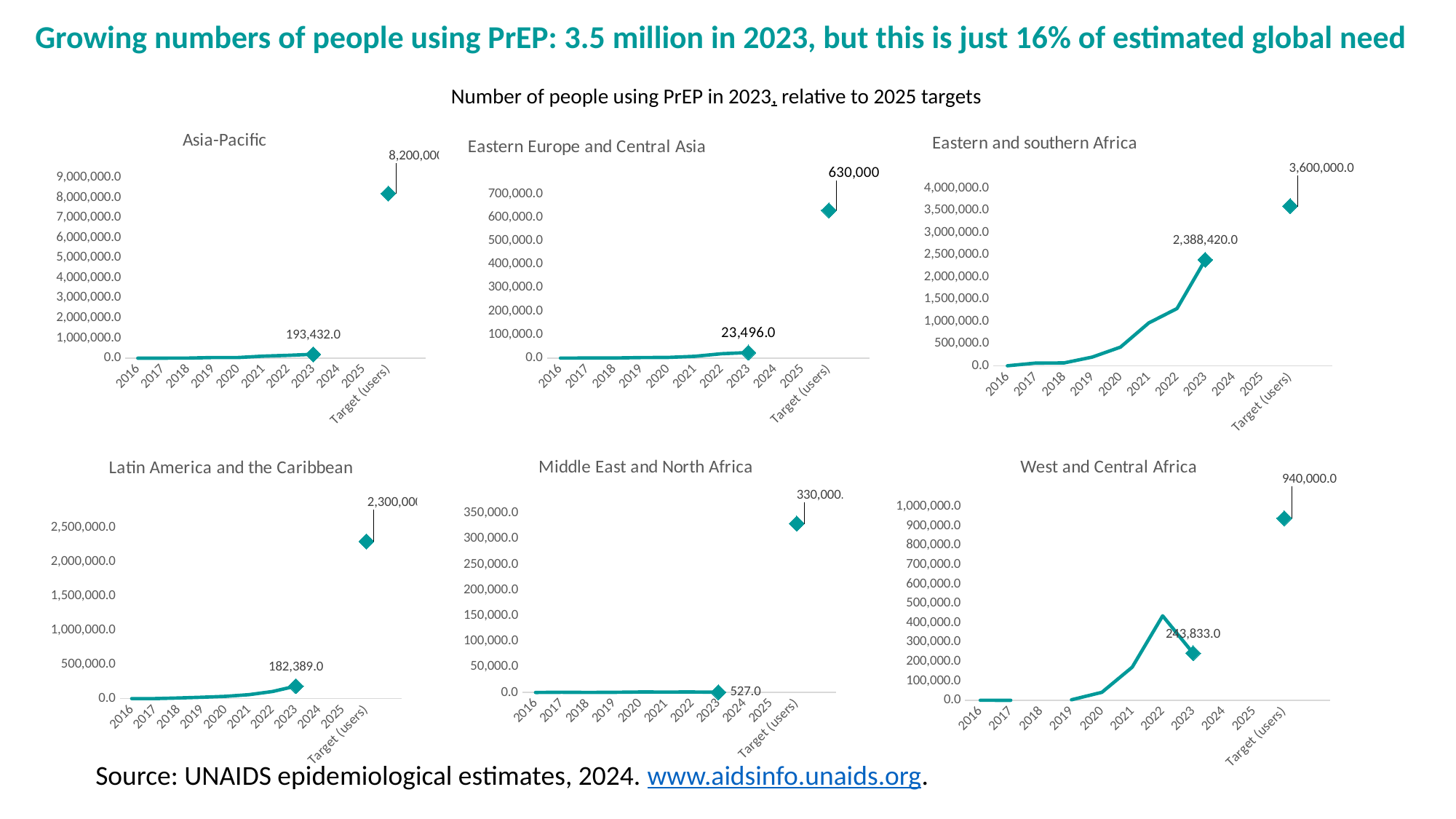
In the West and Central Africa chart, what is the value for 2023? 243,833.0 In the Asia-Pacific chart, what is the value for 2023? 193,432.0 In the Eastern Europe and Central Asia chart, what is the value for 2023? 23,496.0 In the Eastern and southern Africa chart, what is the number of people using PrEP in 2023? 2,388,420.0 In the Eastern and southern Africa chart, how much higher is the target than the 2023 value? 1,211,580.0 In the Eastern and southern Africa chart, is the value for 2022 greater or less than 1,000,000.0? greater In the Middle East and North Africa chart, what is the value for 2023? 527.0 In the West and Central Africa chart, what is the target (users) value? 940,000.0 In the Latin America and the Caribbean chart, what is the value for 2023? 182,389.0 What kind of chart is used for each region on this slide? Line chart In the Eastern and southern Africa chart, what is the 2025 target (users)? 3,600,000.0 In the West and Central Africa chart, which year has the higher value, 2022 or 2023? 2022